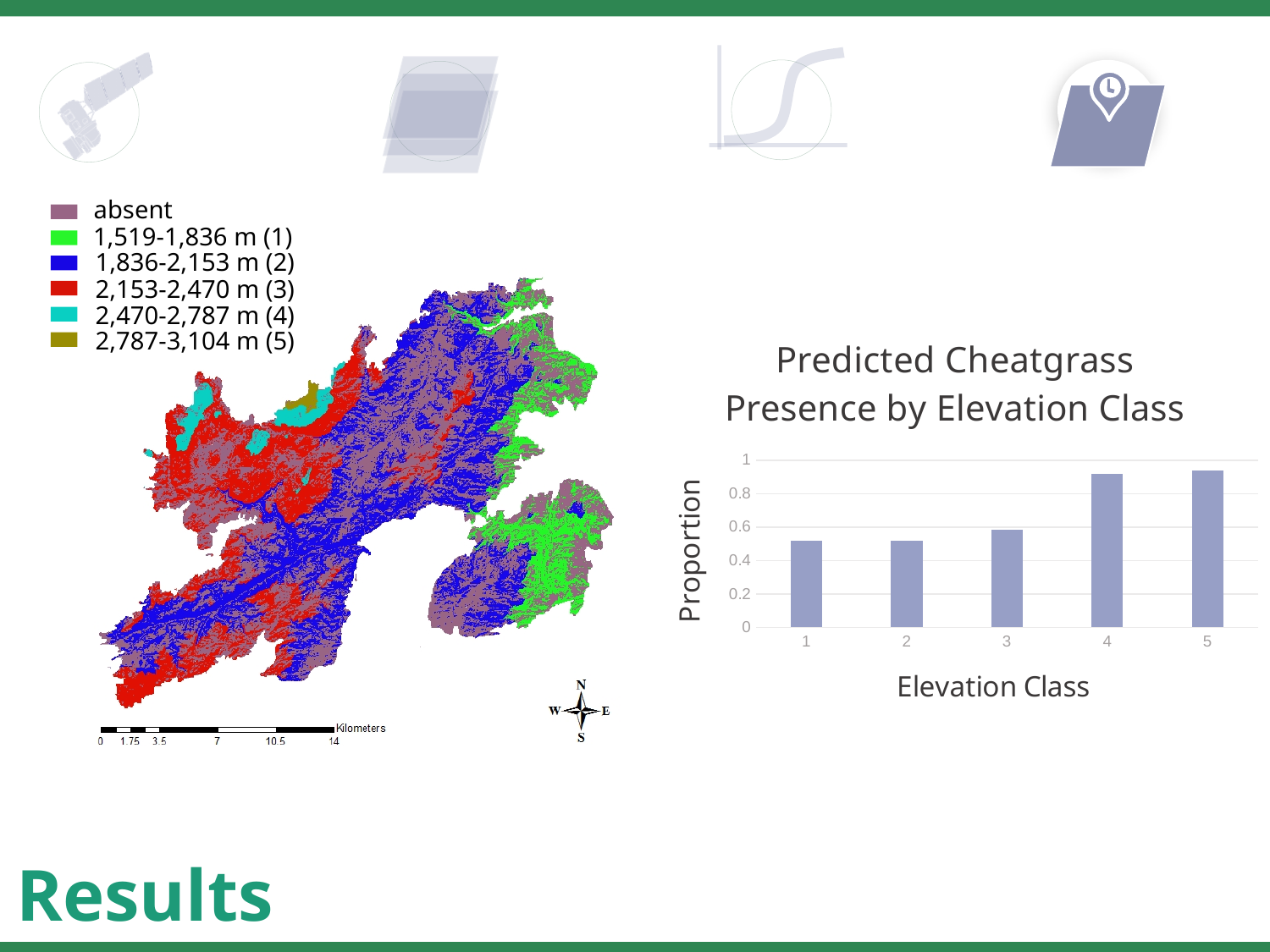
Is the proportion for elevation class 2 greater or less than 0.8? less Is the proportion for elevation class 1 greater or less than 0.6? less What is the label on the vertical axis of the bar chart? Proportion What is the title of the bar chart? Predicted Cheatgrass Presence by Elevation Class Which has the larger proportion, elevation class 1 or elevation class 4? elevation class 4 Do the proportions generally rise or fall as the elevation class increases from 1 to 5? rise Which has the larger proportion, elevation class 2 or elevation class 5? elevation class 5 Is the proportion for elevation class 1 greater or less than 0.4? greater How many elevation classes are plotted in the bar chart? 5 What kind of chart is shown on the right side of the slide? bar chart